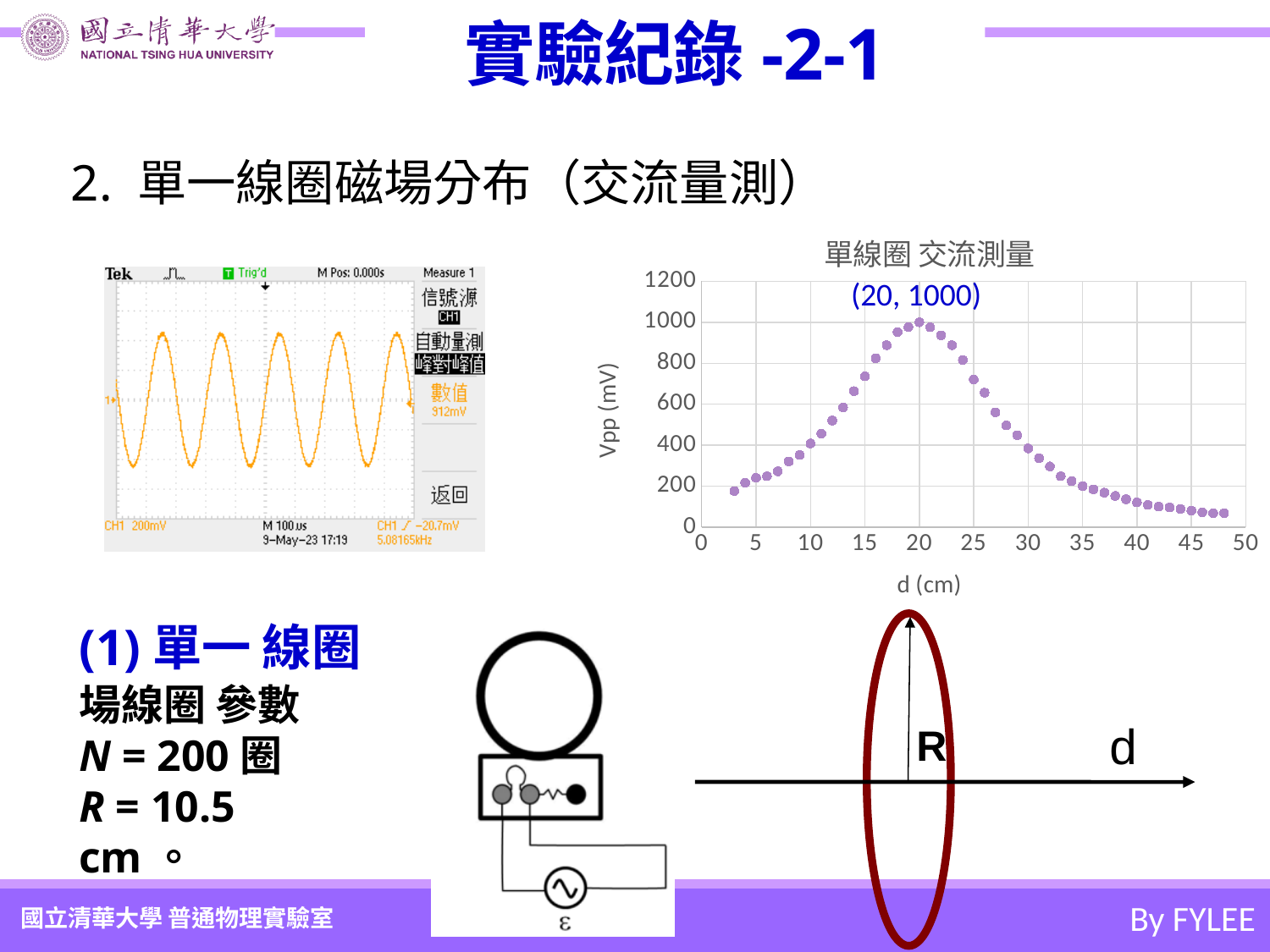
What is the title of the chart on the right of the slide? 單線圈 交流測量 In the '單線圈 交流測量' chart, do the Vpp values rise or fall as d increases from 3 cm to 20 cm? rise In the '單線圈 交流測量' chart, is the Vpp value at d = 25 cm greater or less than 600? greater In the '單線圈 交流測量' chart, is the Vpp value at d = 5 cm greater or less than 400? less In the '單線圈 交流測量' chart, do the Vpp values rise or fall as d increases from 20 cm to 48 cm? fall In the '單線圈 交流測量' chart, which has the larger Vpp: d = 10 cm or d = 40 cm? d = 10 cm What kind of chart is the '單線圈 交流測量' chart? scatter chart What is the label of the vertical axis of the '單線圈 交流測量' chart? Vpp (mV) In the '單線圈 交流測量' chart, what is the Vpp value at d = 20 cm according to the data label? 1000 In the '單線圈 交流測量' chart, at which value of d (cm) is Vpp highest? 20 In the '單線圈 交流測量' chart, is the Vpp value at d = 45 cm greater or less than 200? less